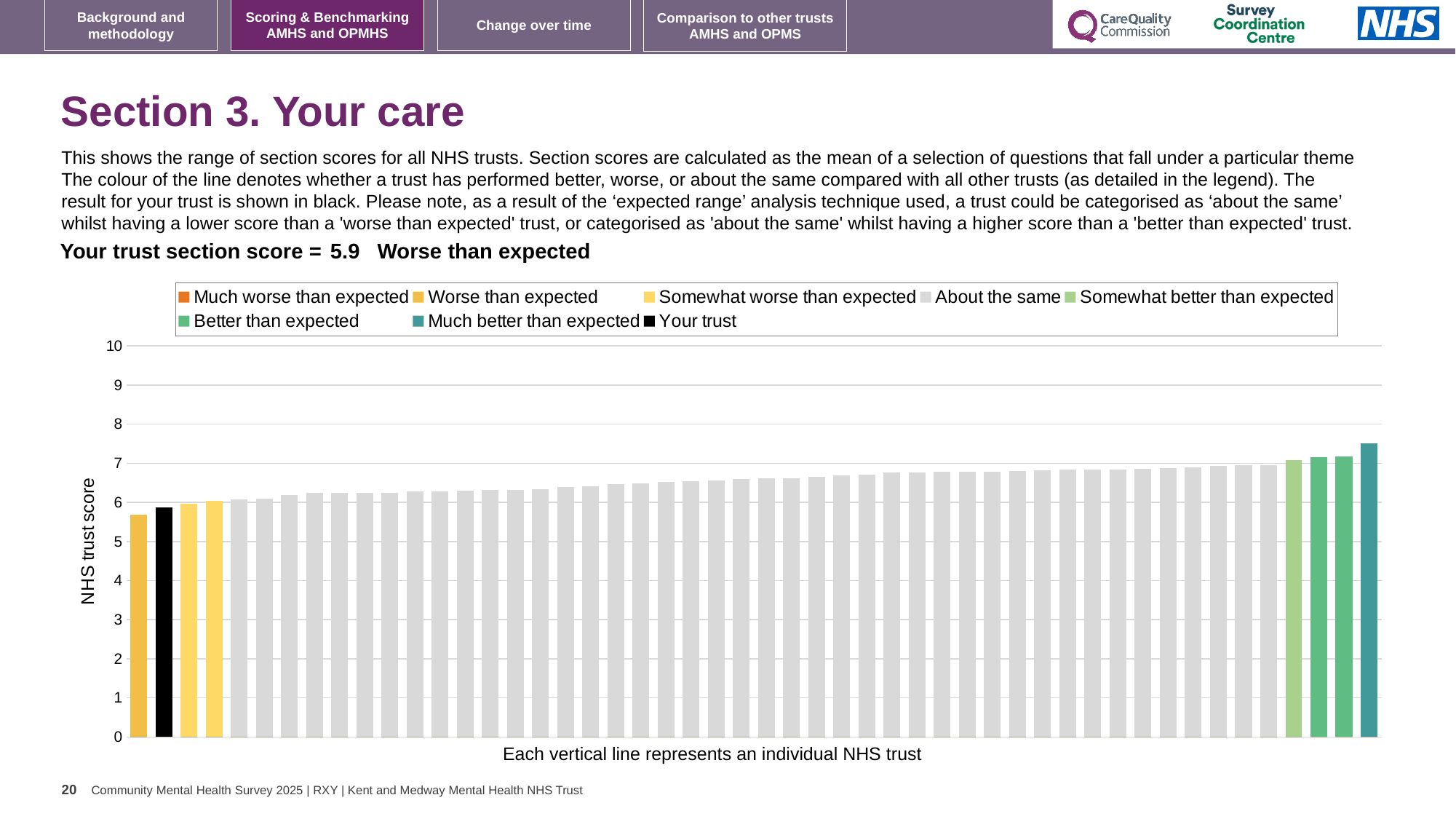
Is the value of the tallest bar greater or less than 8? less What colour is used for the bar representing your trust? black Is the value of the tallest bar greater or less than 7? greater Is the value for your trust (the black bar) greater or less than 5? greater Which performance category is your trust assigned to for Section 3? Worse than expected What is the section score for your trust shown on the slide? 5.9 Do the bar values rise or fall from left to right along the x axis? rise What is the label on the vertical axis of the chart? NHS trust score How many entries does the chart legend list? 8 What kind of chart is shown on the slide? bar chart Which is higher, the leftmost bar or the rightmost bar? the rightmost bar